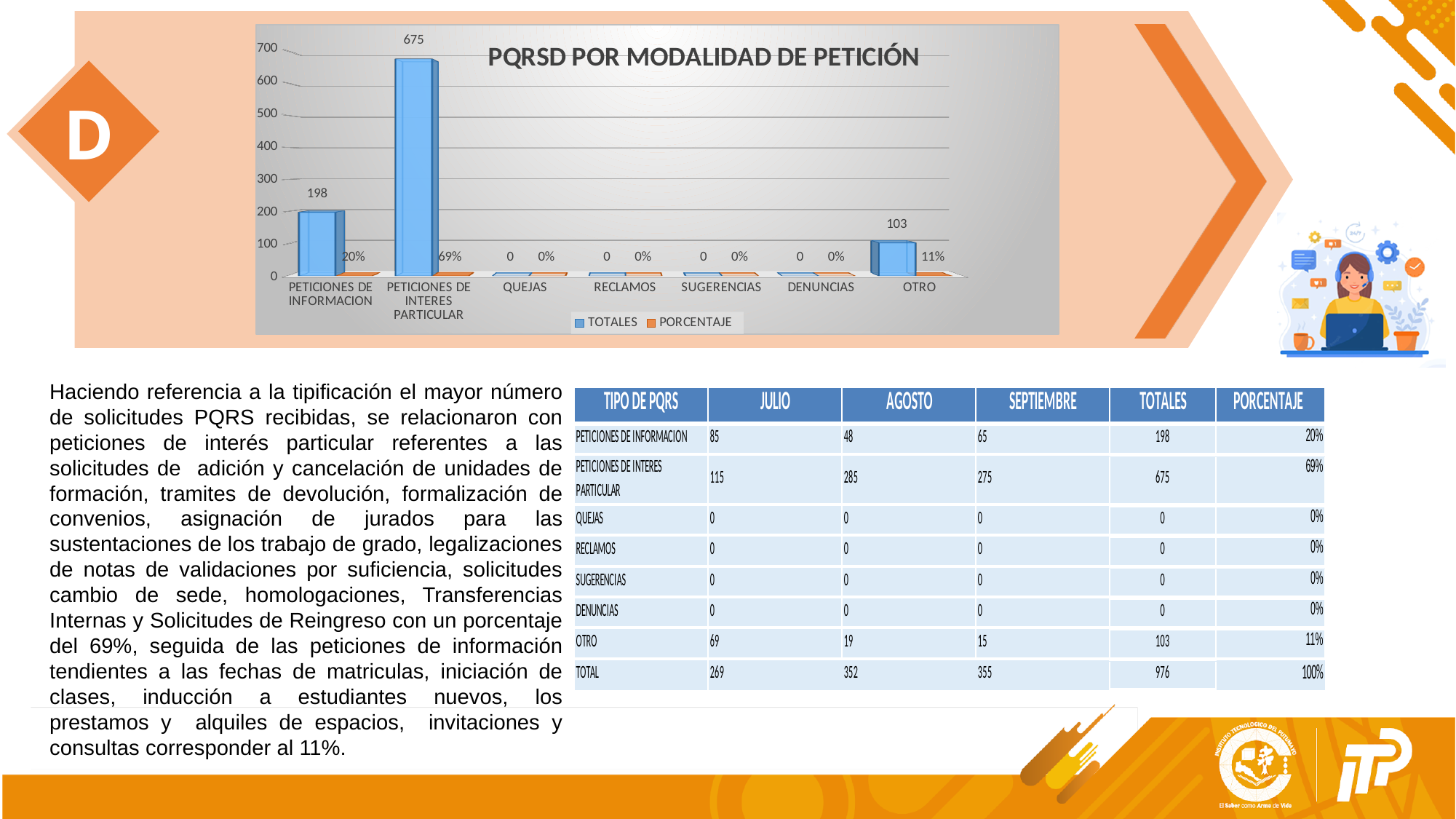
What is the difference between the TOTALES values for PETICIONES DE INTERES PARTICULAR and PETICIONES DE INFORMACION? 477 What type of chart is shown on the slide? Bar chart What is the TOTALES value for PETICIONES DE INFORMACION? 198 What is the title of the chart? PQRSD POR MODALIDAD DE PETICIÓN What is the TOTALES value for PETICIONES DE INTERES PARTICULAR? 675 What is the PORCENTAJE value for PETICIONES DE INTERES PARTICULAR? 69% Which category has the highest TOTALES value? PETICIONES DE INTERES PARTICULAR What is the PORCENTAJE value for OTRO? 11% How many categories are shown on the x axis of the chart? 7 How many series does the chart legend list? 2 Which has a larger TOTALES value, PETICIONES DE INFORMACION or OTRO? PETICIONES DE INFORMACION Is the TOTALES value for PETICIONES DE INTERES PARTICULAR greater or less than 600? greater